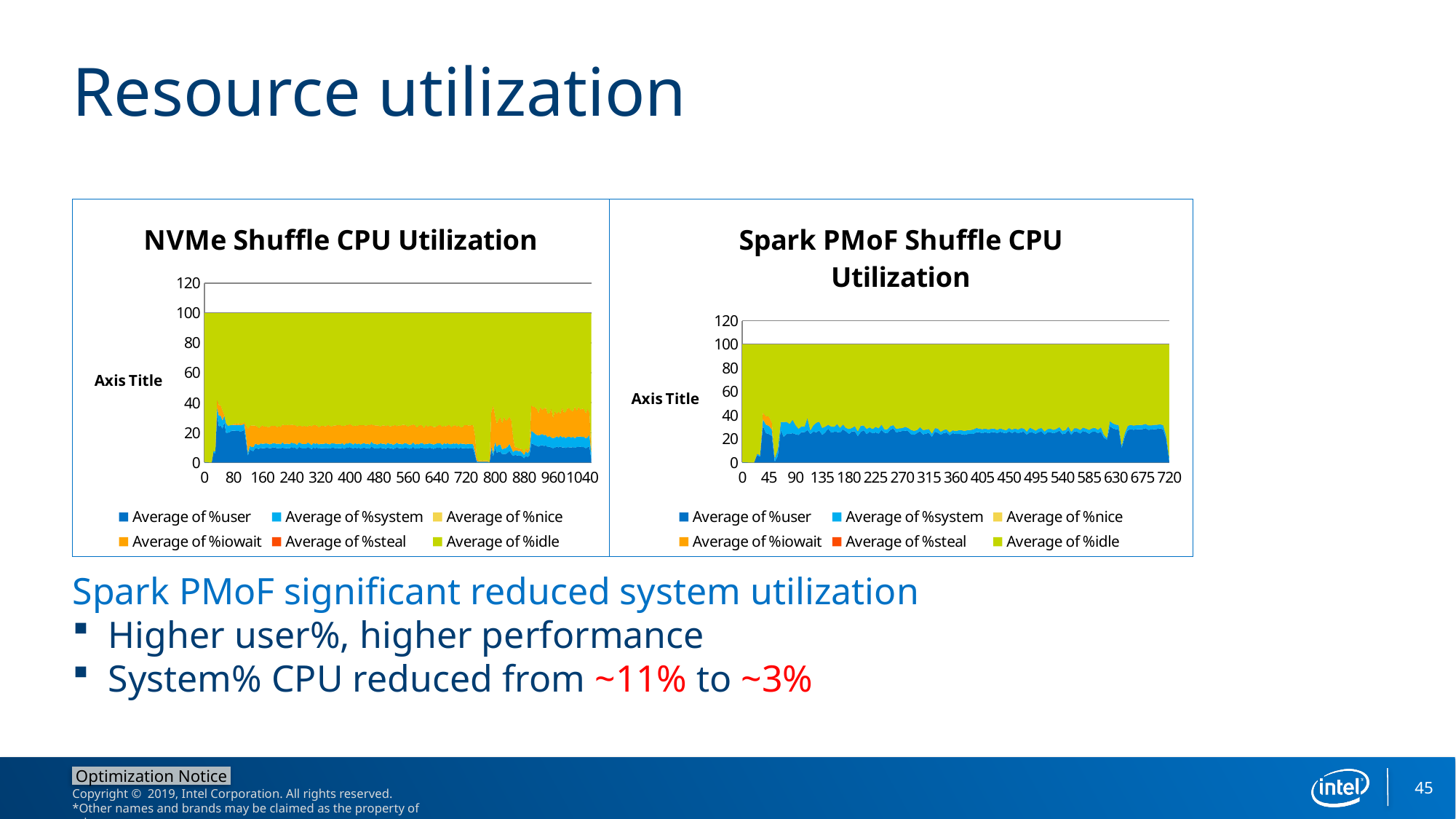
What kind of chart is the Spark PMoF Shuffle CPU Utilization chart? Stacked area chart In the Spark PMoF Shuffle CPU Utilization chart, which series occupies the largest area? Average of %idle In the Spark PMoF Shuffle CPU Utilization chart, is the top of the stacked area greater or less than 80? greater How many series does the legend of the NVMe Shuffle CPU Utilization chart list? 6 In the NVMe Shuffle CPU Utilization chart, is the top of the stacked area greater or less than 120? less In the NVMe Shuffle CPU Utilization chart, which series occupies the largest area? Average of %idle What kind of chart is the NVMe Shuffle CPU Utilization chart? Stacked area chart How many series does the legend of the Spark PMoF Shuffle CPU Utilization chart list? 6 What is the highest tick value shown on the x axis of the NVMe Shuffle CPU Utilization chart? 1040 What is the highest tick value shown on the x axis of the Spark PMoF Shuffle CPU Utilization chart? 720